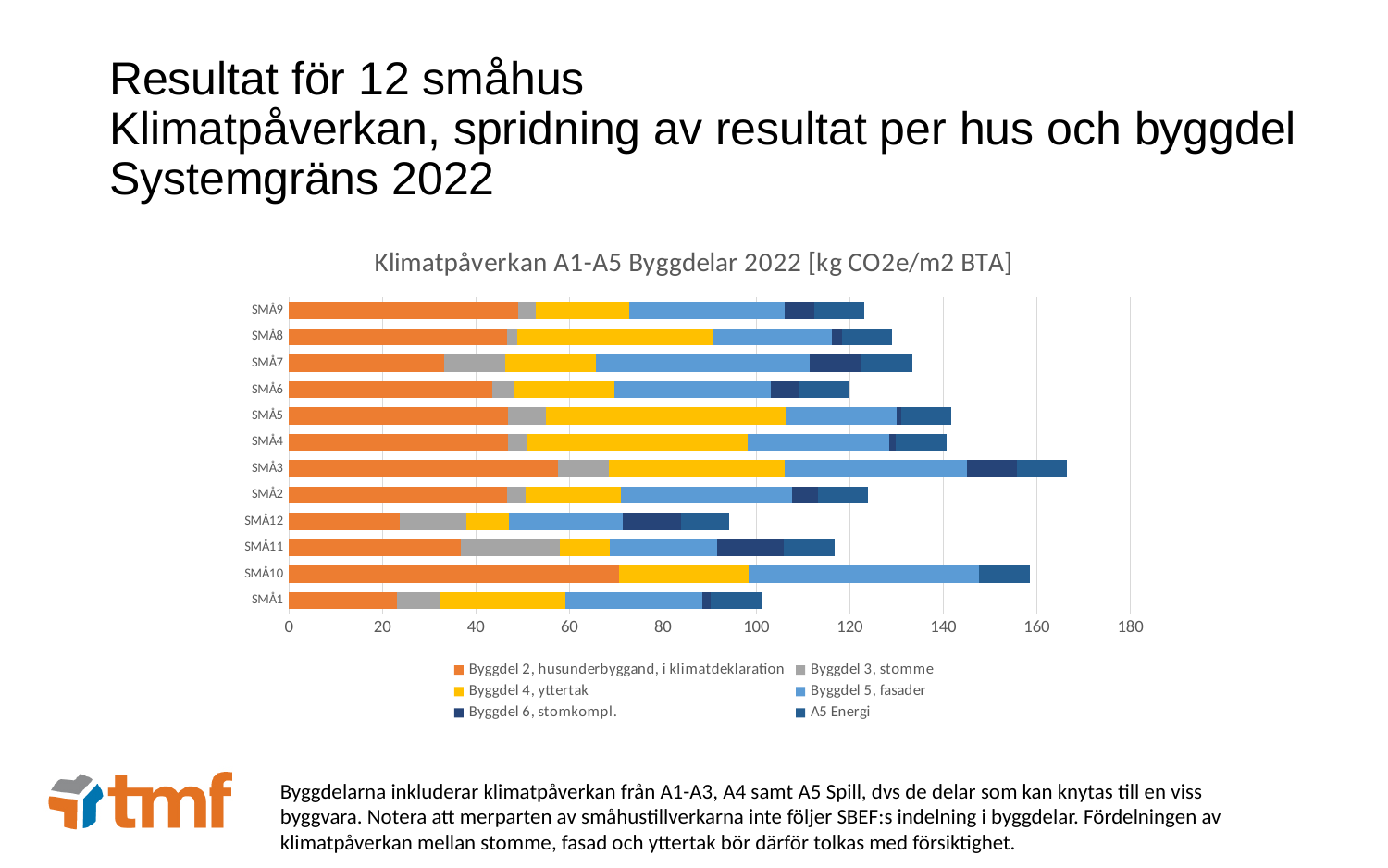
What kind of chart is shown on the slide? Stacked bar chart Is the total value for SMÅ7 greater or less than 120? greater Is the total value for SMÅ12 greater or less than 100? less How many series does the chart legend list? 6 Is the total value for SMÅ10 greater or less than 140? greater What is the title of the chart? Klimatpåverkan A1-A5 Byggdelar 2022 [kg CO2e/m2 BTA] Which has the larger total climate impact, SMÅ10 or SMÅ1? SMÅ10 How many houses (categories) are plotted in the chart? 12 Which house has the lowest total climate impact in the chart? SMÅ12 Which house has the highest total climate impact in the chart? SMÅ3 Which house has the larger 'Byggdel 2, husunderbyggand, i klimatdeklaration' segment, SMÅ10 or SMÅ12? SMÅ10